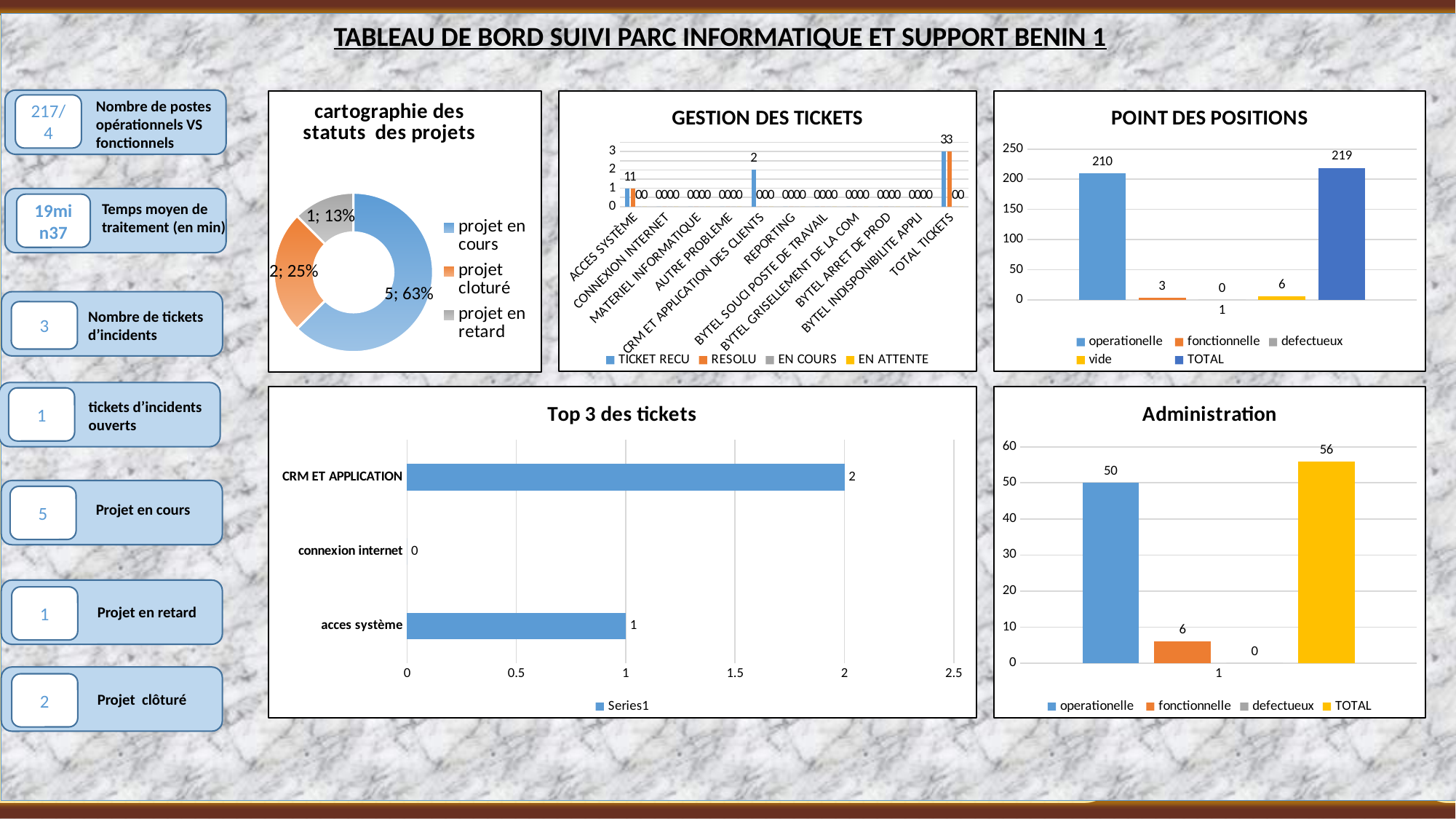
How many categories does the 'cartographie des statuts des projets' chart show? 3 In the 'cartographie des statuts des projets' chart, what value and share are shown for 'projet en cours'? 5; 63% In the 'Top 3 des tickets' chart, what is the value for 'CRM ET APPLICATION'? 2 In the 'cartographie des statuts des projets' chart, which status has the smallest slice? projet en retard In the 'POINT DES POSITIONS' chart, what is the difference between 'TOTAL' and 'operationelle'? 9 In the 'POINT DES POSITIONS' chart, what is the value for 'operationelle'? 210 What kind of chart is 'Top 3 des tickets'? bar chart In the 'Administration' chart, which series has the highest value? TOTAL How many series does the legend of the 'POINT DES POSITIONS' chart list? 5 How many series does the legend of the 'GESTION DES TICKETS' chart list? 4 In the 'cartographie des statuts des projets' chart, what share of the doughnut does 'projet cloturé' represent? 25% In the 'Administration' chart, what is the value for 'fonctionnelle'? 6